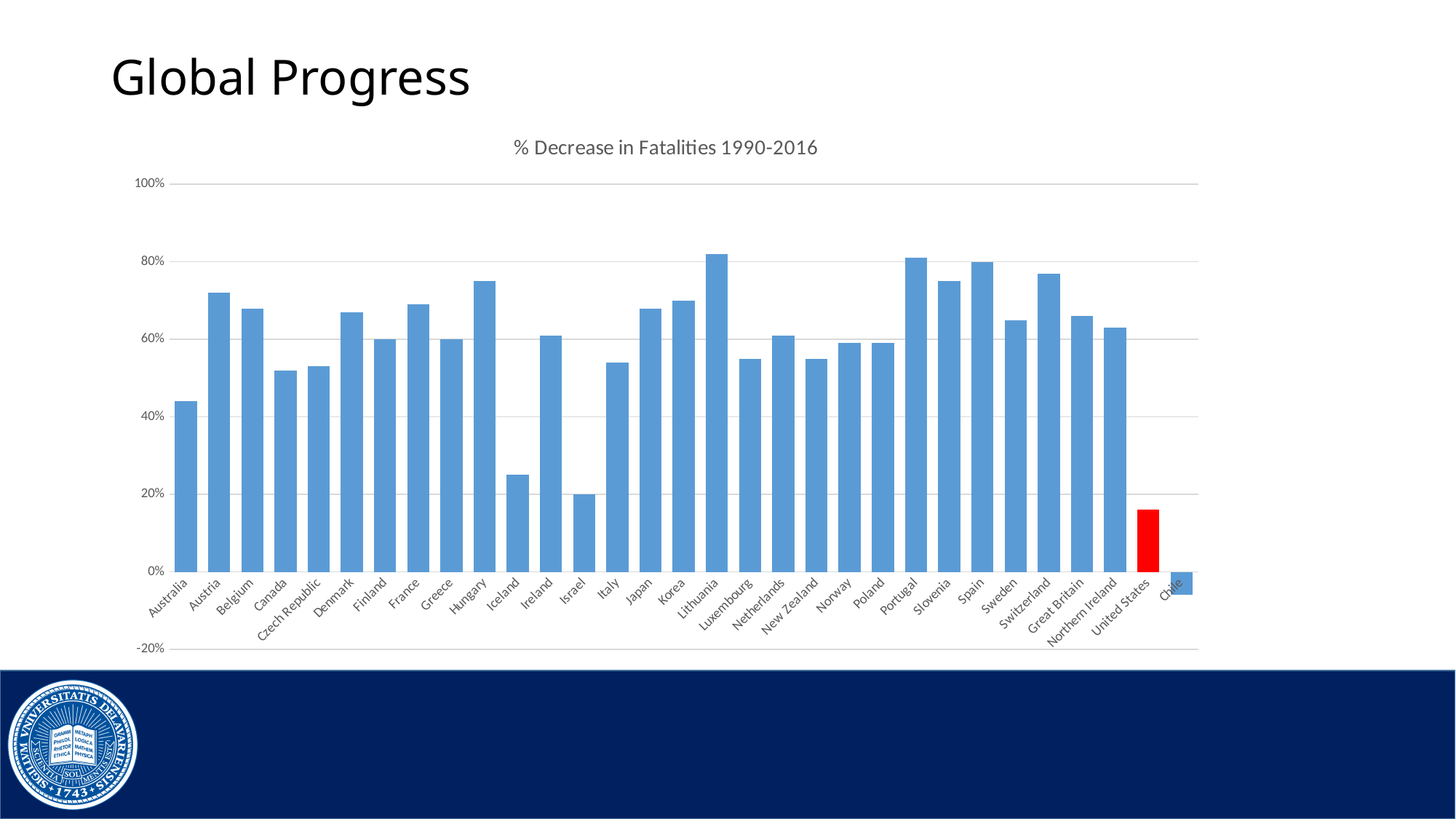
Which country's bar is coloured red instead of blue? United States Is the value for Hungary greater or less than 80%? less How many countries are shown on the x axis of the chart? 31 Which has a larger value, Israel or Lithuania? Lithuania Which has a larger value, Austria or Canada? Austria What kind of chart is shown on the slide? bar chart Which country has the lowest value in the chart? Chile Is the value for Australia greater or less than 40%? greater Is the value for United States greater or less than 20%? less What is the title of the chart? % Decrease in Fatalities 1990-2016